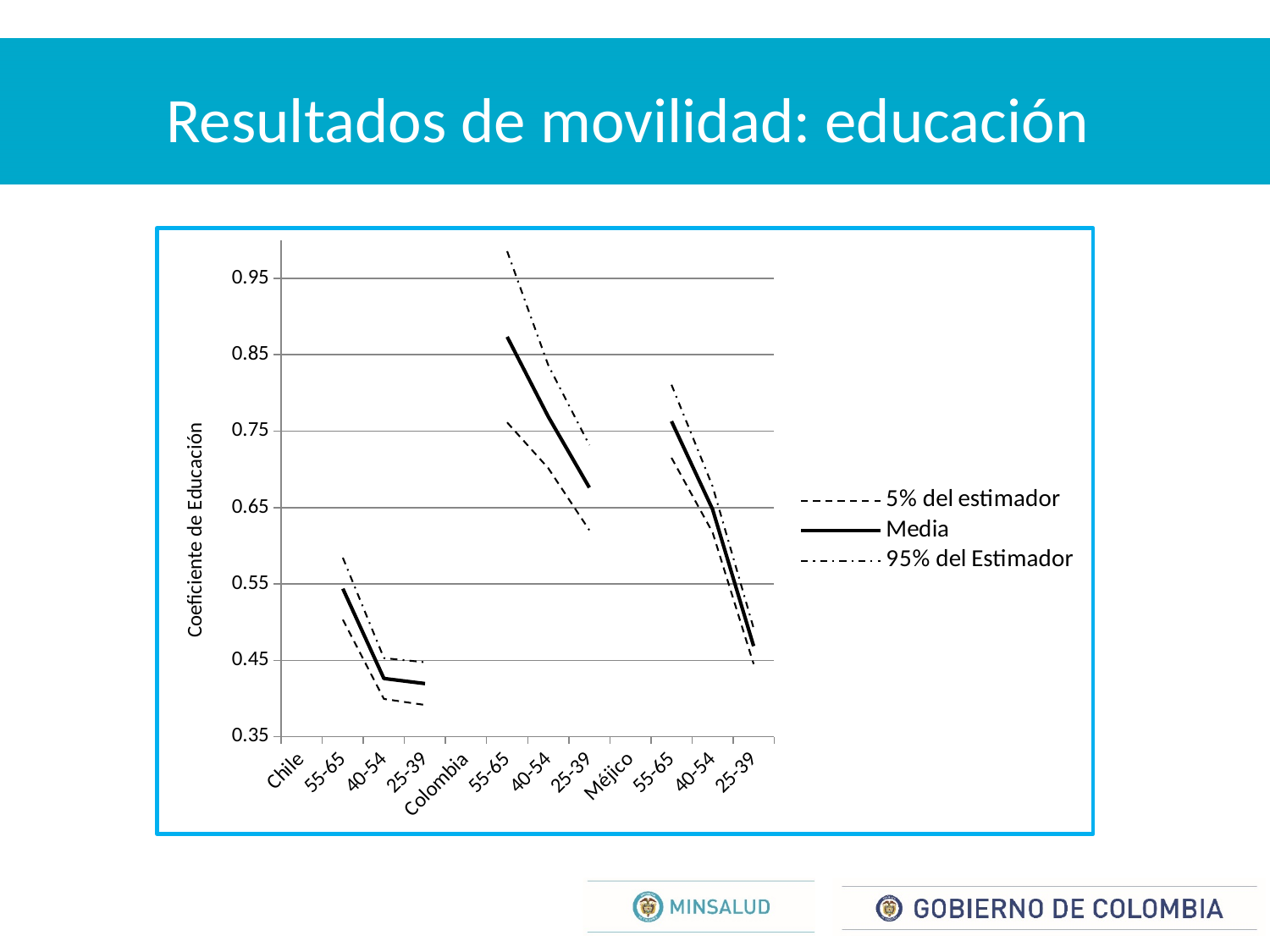
Which country has the highest Media value for the 55-65 age group? Colombia What are the three series named in the legend? 5% del estimador, Media, 95% del Estimador What is the title of the vertical axis? Coeficiente de Educación How many countries are labelled on the x axis? 3 What kind of chart is shown on the slide? line chart Within each country, does the Media line rise or fall from the 55-65 group to the 25-39 group? fall Is the Media value for the Colombia 55-65 group greater or less than 0.75? greater Is the Media value for the Chile 55-65 group greater or less than 0.65? less How many series does the legend list? 3 Is the Media value for the Méjico 55-65 group greater or less than 0.65? greater Which country has the lowest Media value for the 55-65 age group? Chile